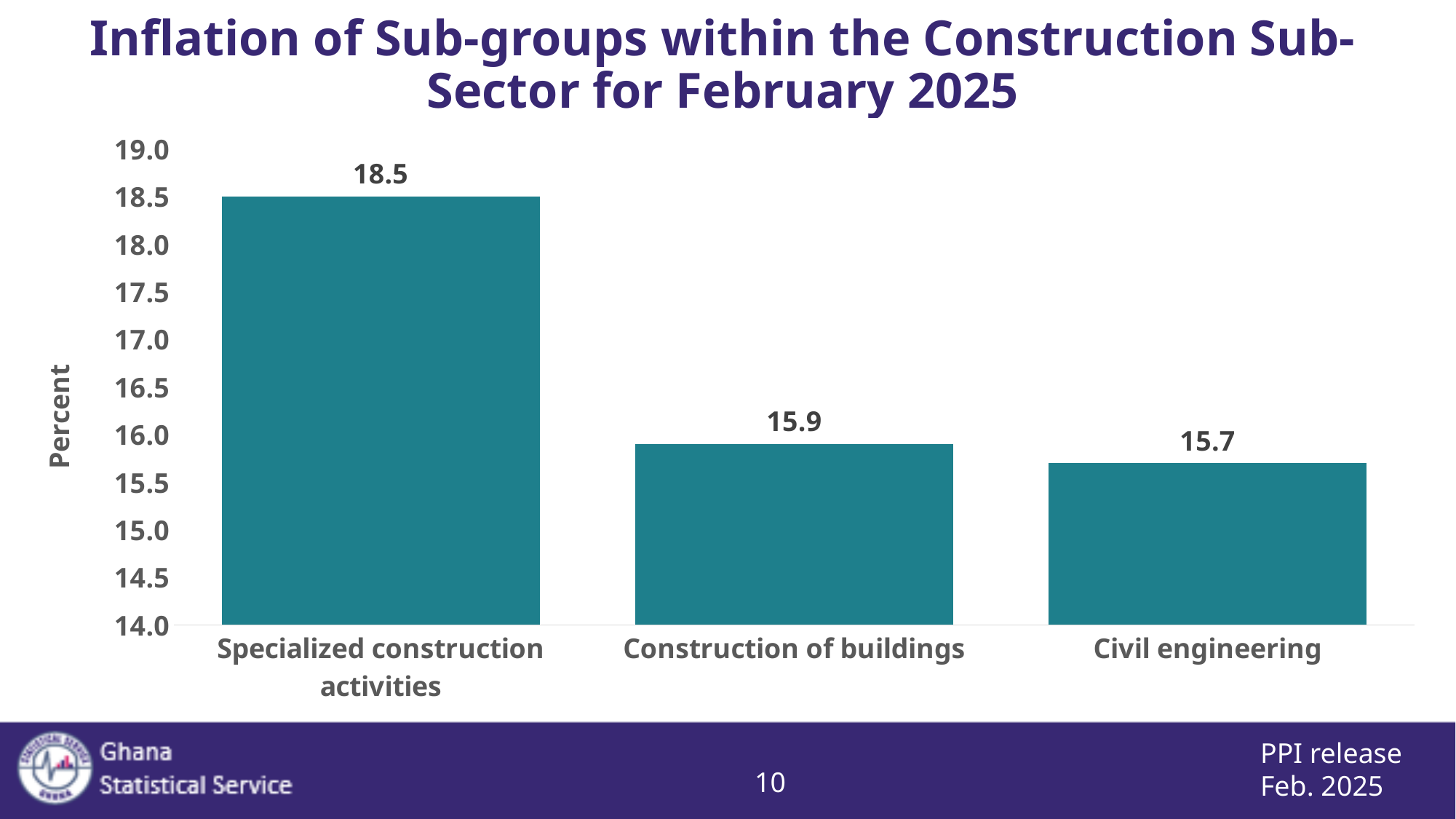
Which has a higher inflation rate, Specialized construction activities or Construction of buildings? Specialized construction activities Is the value for Construction of buildings greater or less than 16.0? less Which sub-group has the highest inflation rate? Specialized construction activities Which sub-group has the lowest inflation rate? Civil engineering How many sub-groups are shown in the chart? 3 What is the difference between the inflation rates for Specialized construction activities and Civil engineering? 2.8 What kind of chart is shown on the slide? Bar chart What is the label on the vertical axis of the chart? Percent What is the inflation rate for Specialized construction activities? 18.5 What is the difference between the inflation rates for Construction of buildings and Civil engineering? 0.2 What is the inflation rate for Construction of buildings? 15.9 What is the inflation rate for Civil engineering? 15.7